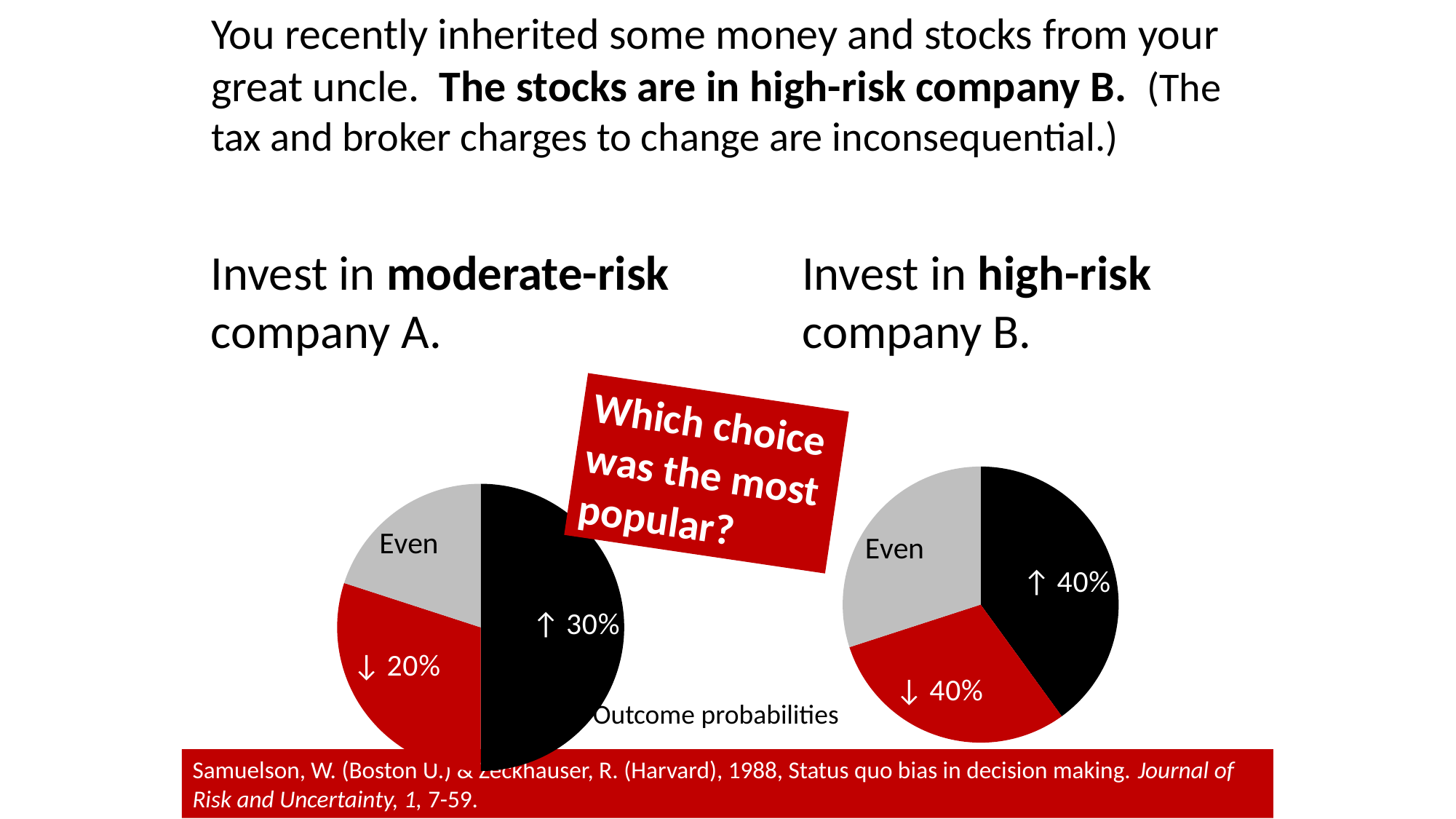
In the pie chart for moderate-risk company A (left), which is larger, the up (↑) slice or the down (↓) slice? The up (↑) slice What colour is the down (↓) slice in both pie charts? Red How many slices does the pie chart for moderate-risk company A (left) have? 3 In the pie chart for moderate-risk company A (left), which slice is the largest? The up (↑ 30%) slice What kind of charts are used to show the outcome probabilities on this slide? Pie charts